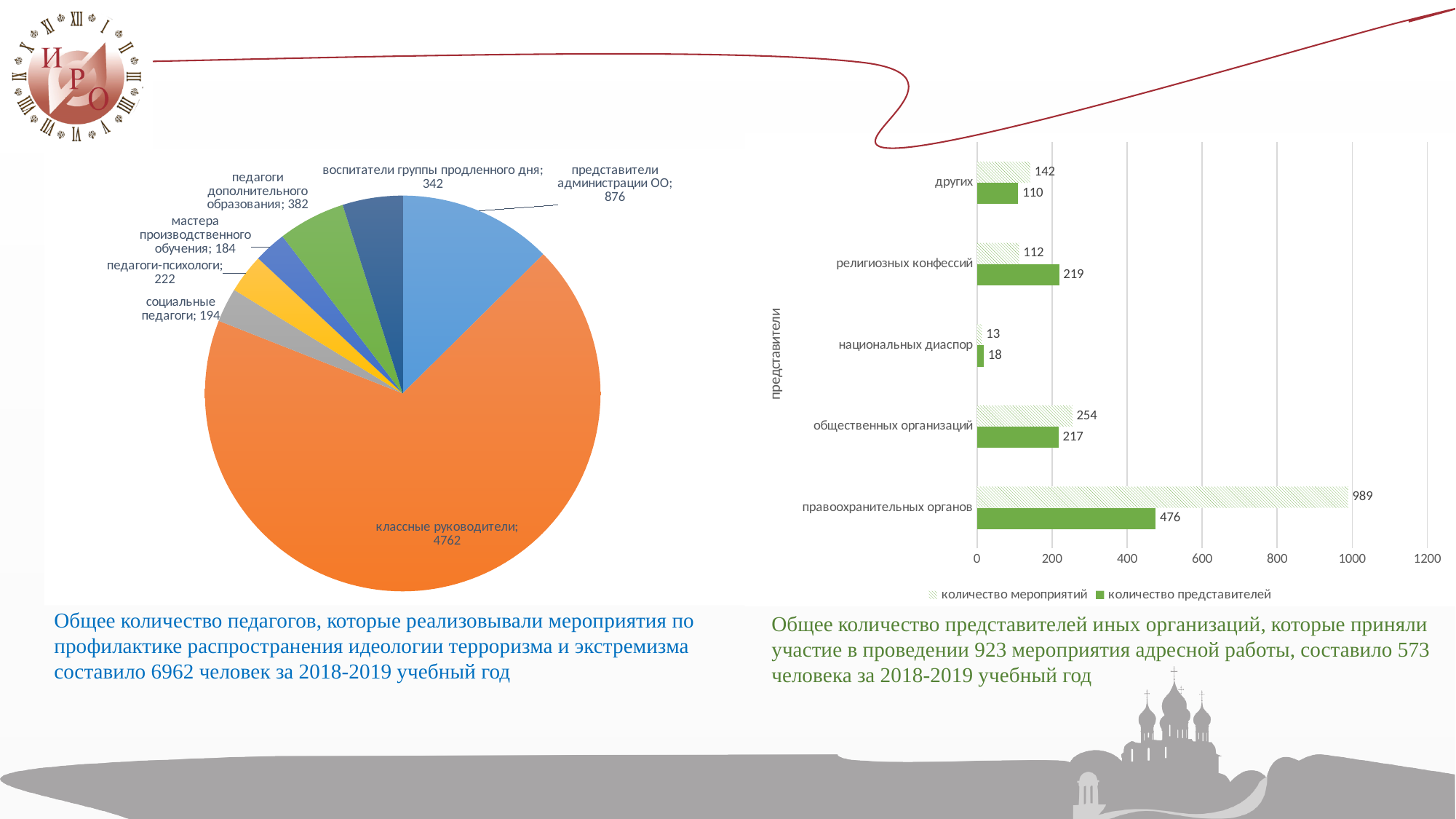
In the bar chart on the right, what is the количество представителей for религиозных конфессий? 219 In the pie chart on the left, which is larger: педагоги-психологи or социальные педагоги? педагоги-психологи What type of chart is shown on the right side of the slide? bar chart In the bar chart on the right, what is the количество мероприятий for правоохранительных органов? 989 In the bar chart on the right, which category has the lowest количество представителей? национальных диаспор In the bar chart on the right, how many series does the legend list? 2 In the pie chart on the left, which category has the smallest value? мастера производственного обучения In the pie chart on the left, what is the difference between педагоги дополнительного образования and воспитатели группы продленного дня? 40 In the bar chart on the right, what is the difference between количество мероприятий and количество представителей for общественных организаций? 37 In the pie chart on the left, what is the value for представители администрации ОО? 876 In the pie chart on the left, what is the value for классные руководители? 4762 In the pie chart on the left, how many slices are there? 7